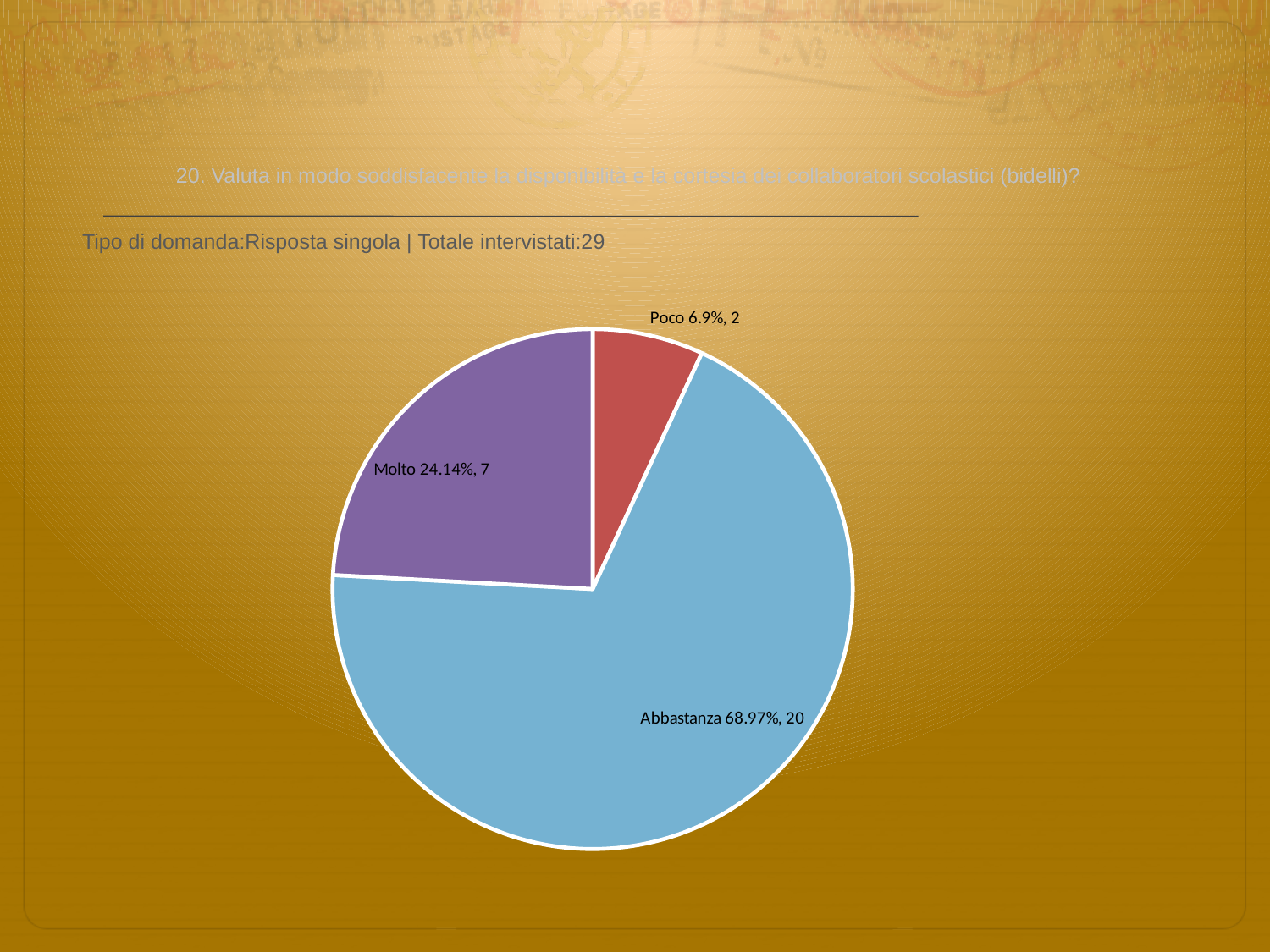
How many respondents answered Molto? 7 Which category has the smallest slice? Poco Which category has the largest slice? Abbastanza How many respondents answered Poco? 2 Which slice is larger, Molto or Poco? Molto What percentage share does the Abbastanza slice have? 68.97% How many respondents answered Abbastanza? 20 What kind of chart is shown on the slide? pie chart What is the difference in respondent count between Abbastanza and Molto? 13 What percentage share does the Molto slice have? 24.14% How many slices does the pie chart have? 3 What percentage share does the Poco slice have? 6.9%